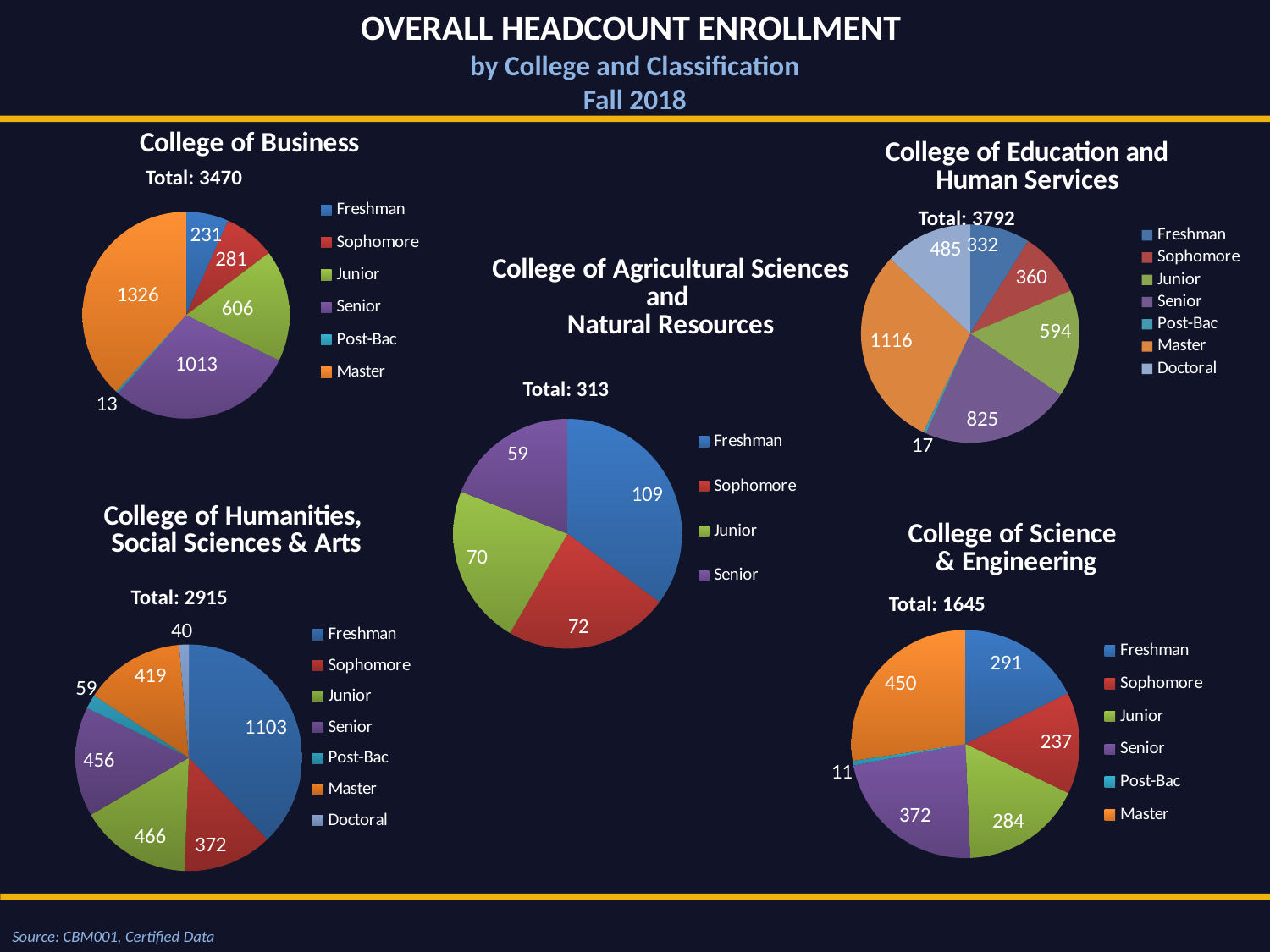
How many slices does the College of Agricultural Sciences and Natural Resources chart have? 4 In the College of Education and Human Services chart, which is larger, Junior or Senior? Senior In the College of Education and Human Services chart, what is the value for Doctoral? 485 In the College of Science & Engineering chart, what is the difference between Master and Sophomore? 213 In the College of Agricultural Sciences and Natural Resources chart, what is the difference between Freshman and Senior? 50 In the College of Humanities, Social Sciences & Arts chart, which classification has the largest slice? Freshman What total is shown for the College of Humanities, Social Sciences & Arts chart? 2915 How many entries does the legend of the College of Education and Human Services chart list? 7 What kind of chart is used for the College of Science & Engineering? Pie chart In the College of Science & Engineering chart, what is the value for Senior? 372 In the College of Business chart, which classification has the smallest slice? Post-Bac In the College of Business chart, how many Master students are there? 1326